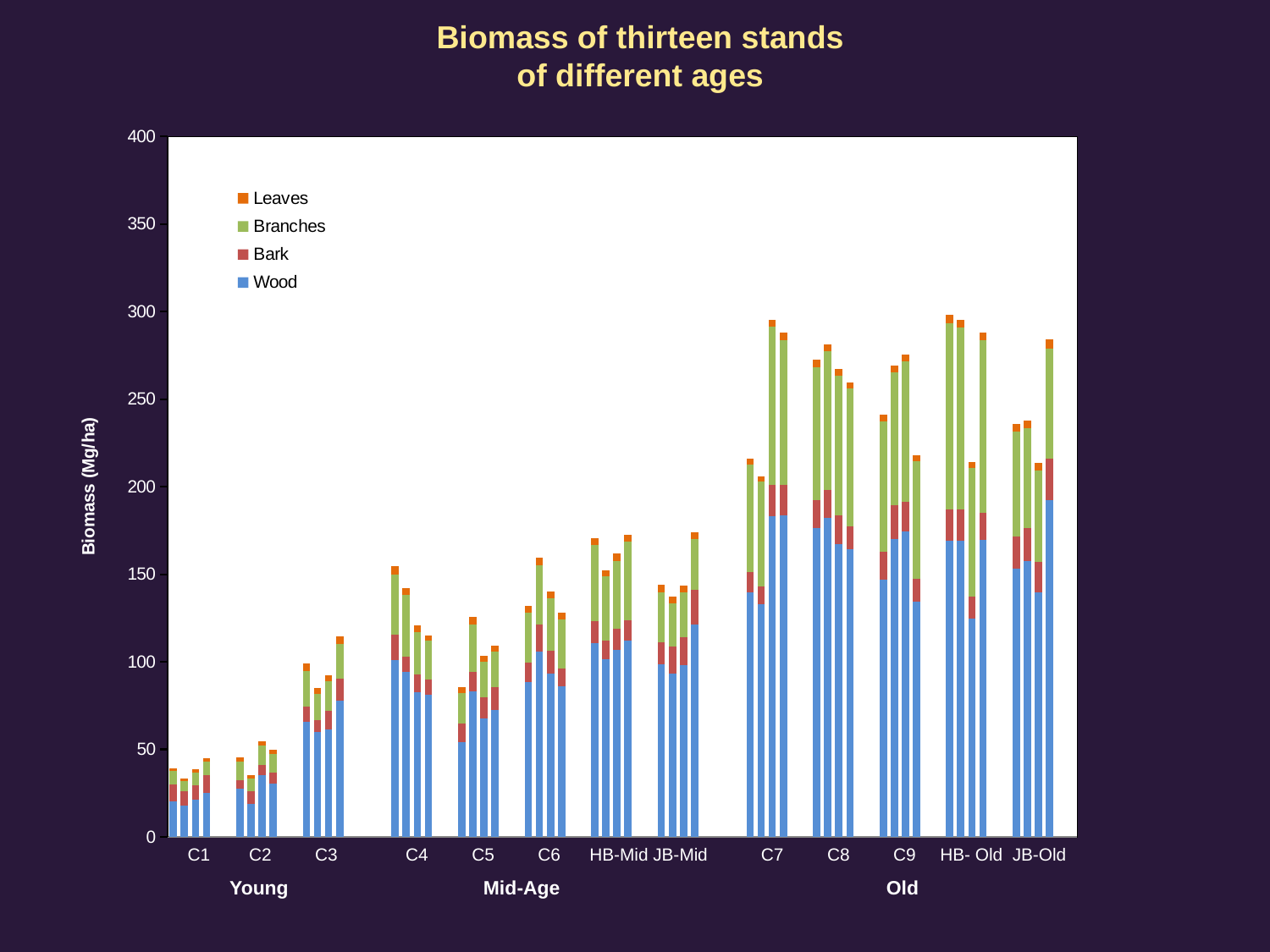
What is the label of the y axis? Biomass (Mg/ha) How many series does the legend list? 4 What is the title of the chart? Biomass of thirteen stands of different ages Which stand has the lowest biomass bars? C1 How many stands are labelled along the x axis? 13 Is the tallest bar for C7 greater or less than 250 Mg/ha? greater What kind of chart is shown on the slide? Stacked bar chart Which stand has higher biomass bars, C4 or C2? C4 Are the bars for C3 greater or less than 150 Mg/ha? less Are the biomass values for the C1 bars greater or less than 50 Mg/ha? less Which stand has higher biomass bars, C7 or C1? C7 Do the biomass values generally rise or fall moving from the Young stands to the Old stands along the x axis? rise